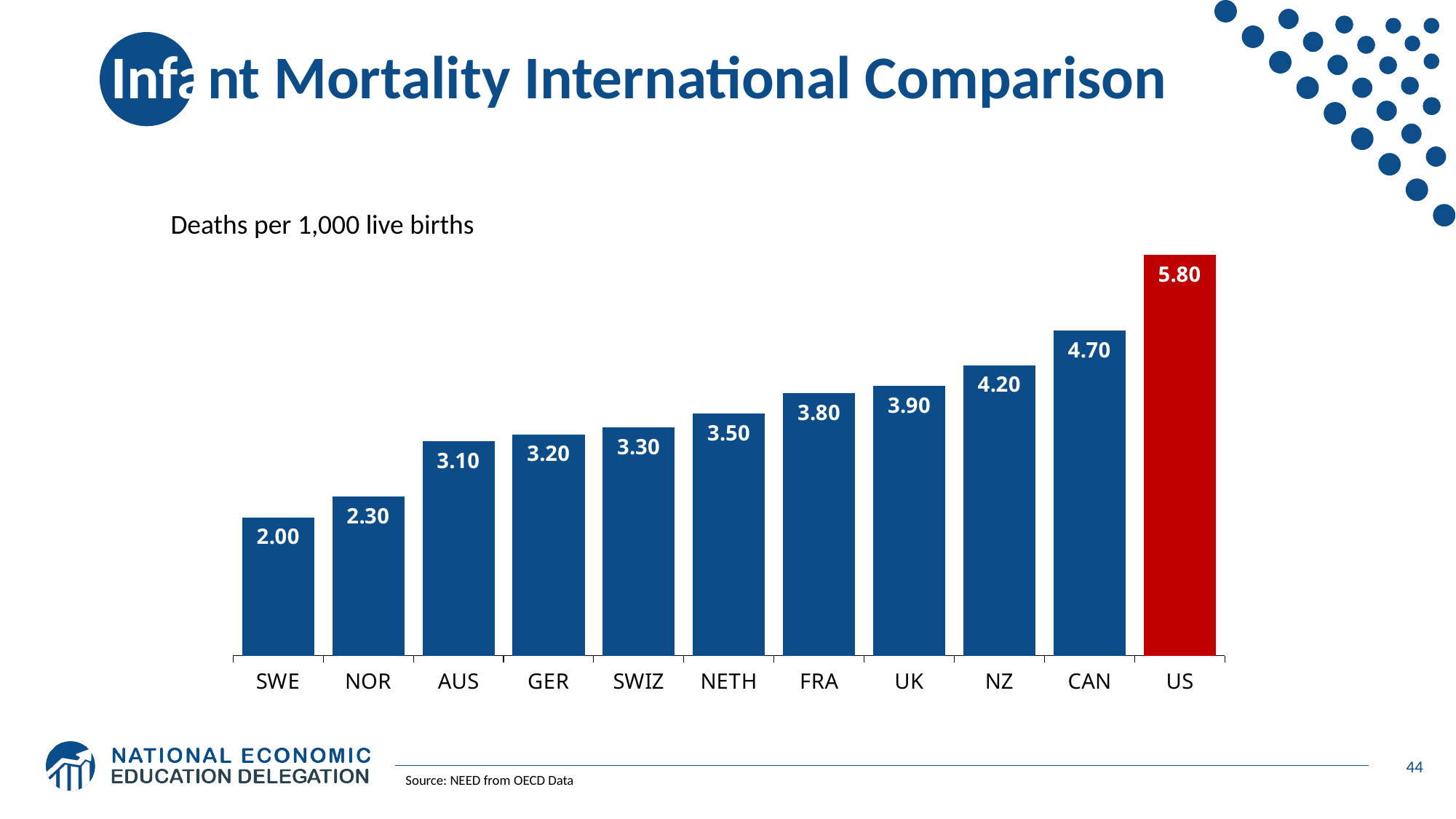
Which has a higher infant mortality value, UK or FRA? UK What is the difference between the values for NOR and SWE? 0.30 Which country has the lowest infant mortality rate on the chart? SWE Which bar is coloured red rather than blue? US Which country has the highest infant mortality rate on the chart? US Do the values rise or fall moving from left to right along the x axis? Rise What kind of chart is shown on the slide? Bar chart What is the difference between the values for US and CAN? 1.10 What is the infant mortality value for GER? 3.20 What is the infant mortality value for the US? 5.80 What is the infant mortality value for NZ? 4.20 How many countries are shown on the chart? 11